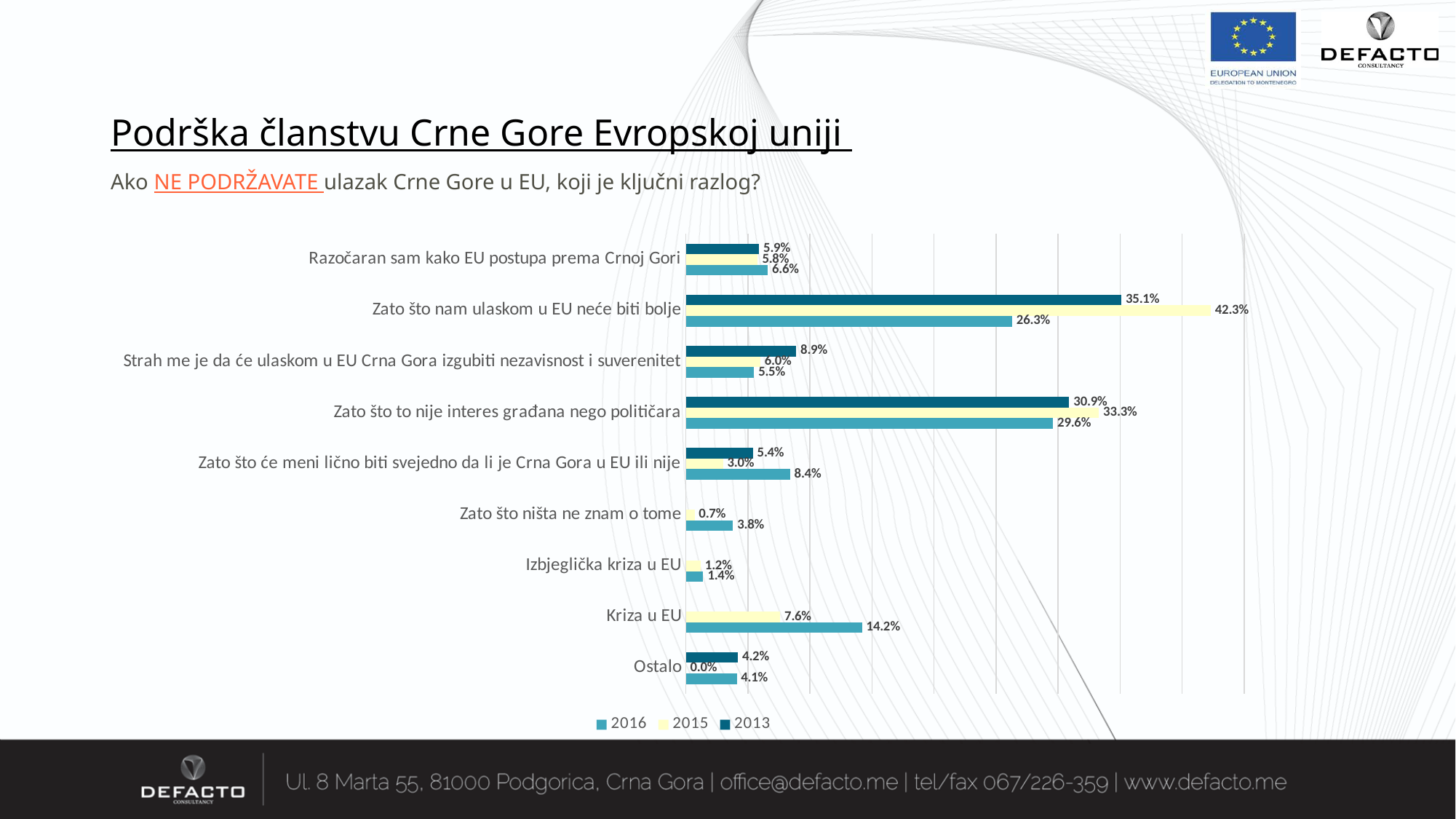
What kind of chart is shown on the slide? Bar chart How many series does the legend list? 3 What is the difference between the 2015 and 2016 values for "Zato što nam ulaskom u EU neće biti bolje"? 16.0% How many categories are shown on the chart? 9 What is the 2015 value for "Zato što nam ulaskom u EU neće biti bolje"? 42.3% Which category has the highest 2016 value? Zato što to nije interes građana nego političara Which category has the lowest 2015 value? Ostalo What is the 2016 value for "Kriza u EU"? 14.2% What is the 2013 value for "Zato što to nije interes građana nego političara"? 30.9% Which is larger for "Kriza u EU": the 2015 value or the 2016 value? 2016 What is the difference between the 2013 and 2016 values for "Strah me je da će ulaskom u EU Crna Gora izgubiti nezavisnost i suverenitet"? 3.4% Which years are listed in the chart legend? 2016, 2015, 2013